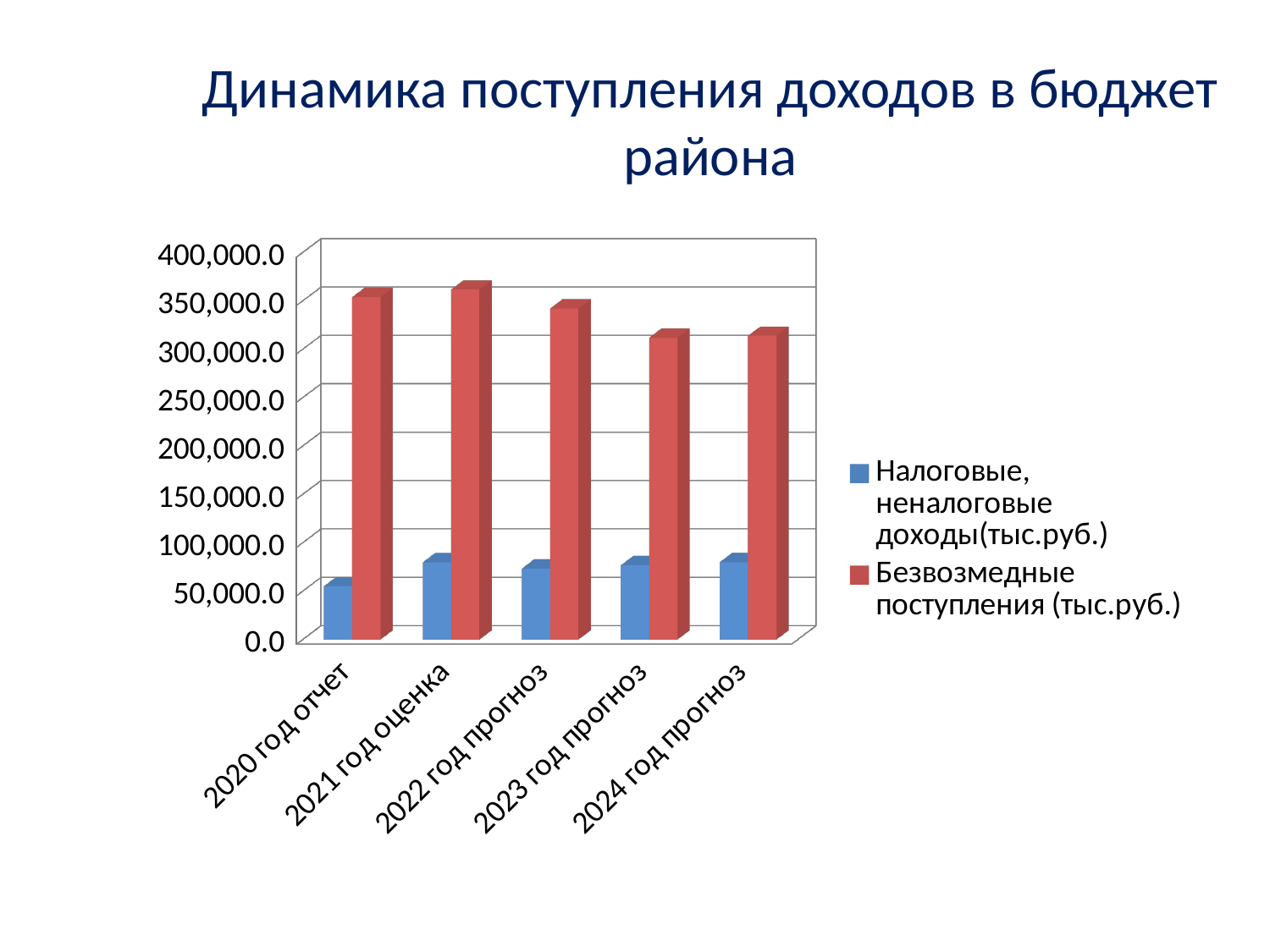
What kind of chart is shown on the slide? bar chart Is the value of Налоговые, неналоговые доходы for 2020 год отчет greater or less than 100,000.0? less Which series is shown in red in the chart? Безвозмедные поступления (тыс.руб.) Is the value of Безвозмездные поступления for 2020 год отчет greater or less than 300,000.0? greater Which is larger: Безвозмездные поступления for 2020 год отчет or for 2023 год прогноз? 2020 год отчет What is the title of the chart on the slide? Динамика поступления доходов в бюджет района In which year is the value of Безвозмездные поступления the highest? 2021 год оценка Is the value of Безвозмездные поступления for 2023 год прогноз greater or less than 350,000.0? less How many categories (years) are shown on the x axis of the chart? 5 In which year is the value of Налоговые, неналоговые доходы the lowest? 2020 год отчет How many series does the legend list? 2